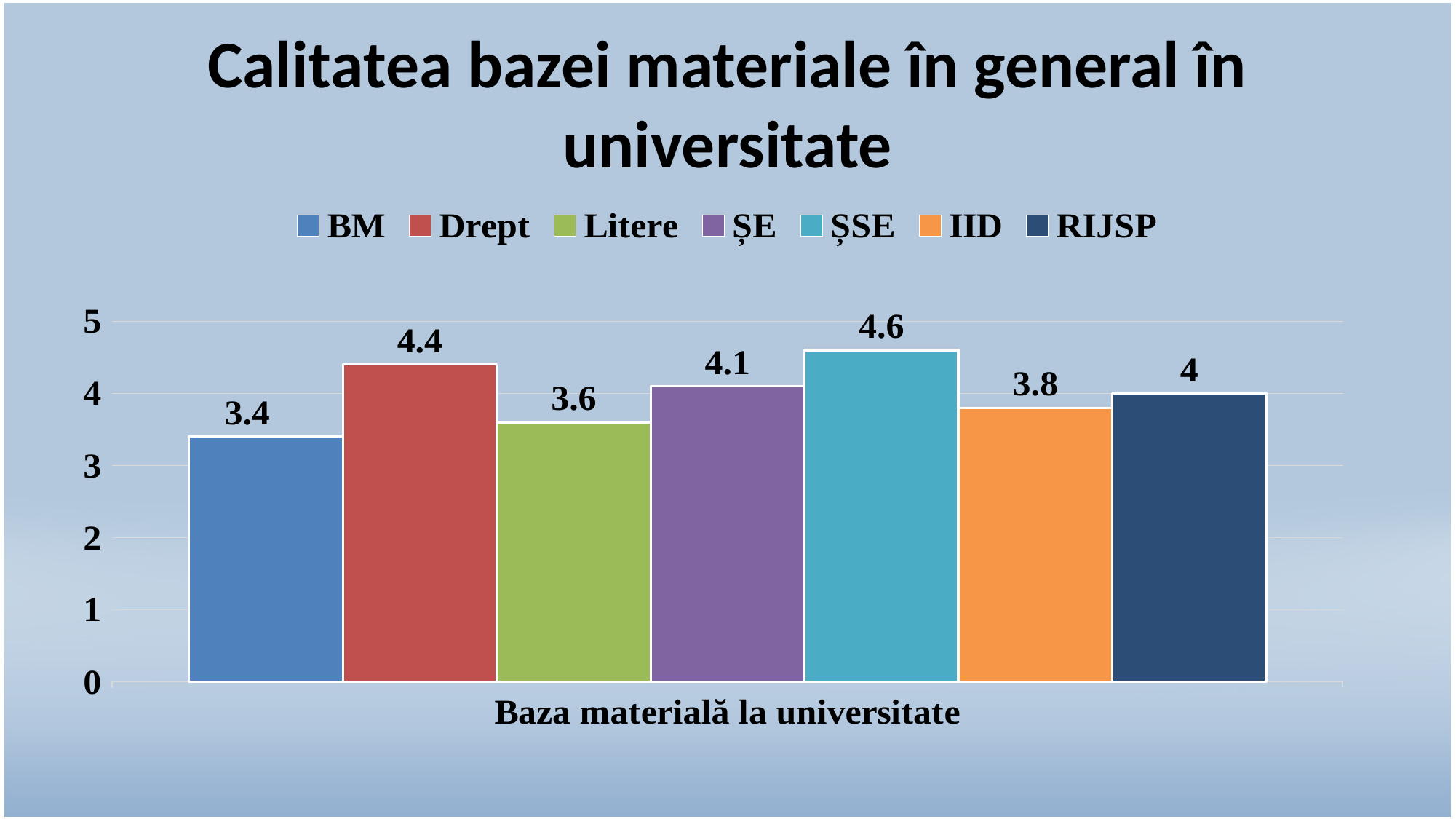
How many series does the legend list? 7 Which series has the highest value? ȘSE What is the value for IID? 3.8 What is the value for ȘSE? 4.6 What is the difference between the values for Drept and Litere? 0.8 What is the label on the x axis? Baza materială la universitate What kind of chart is shown on the slide? bar chart Is the value for Drept greater or less than 4? greater Which series has the lowest value? BM What is the title of the chart? Calitatea bazei materiale în general în universitate Which is larger, the value for ȘE or the value for RIJSP? ȘE What is the value for BM? 3.4